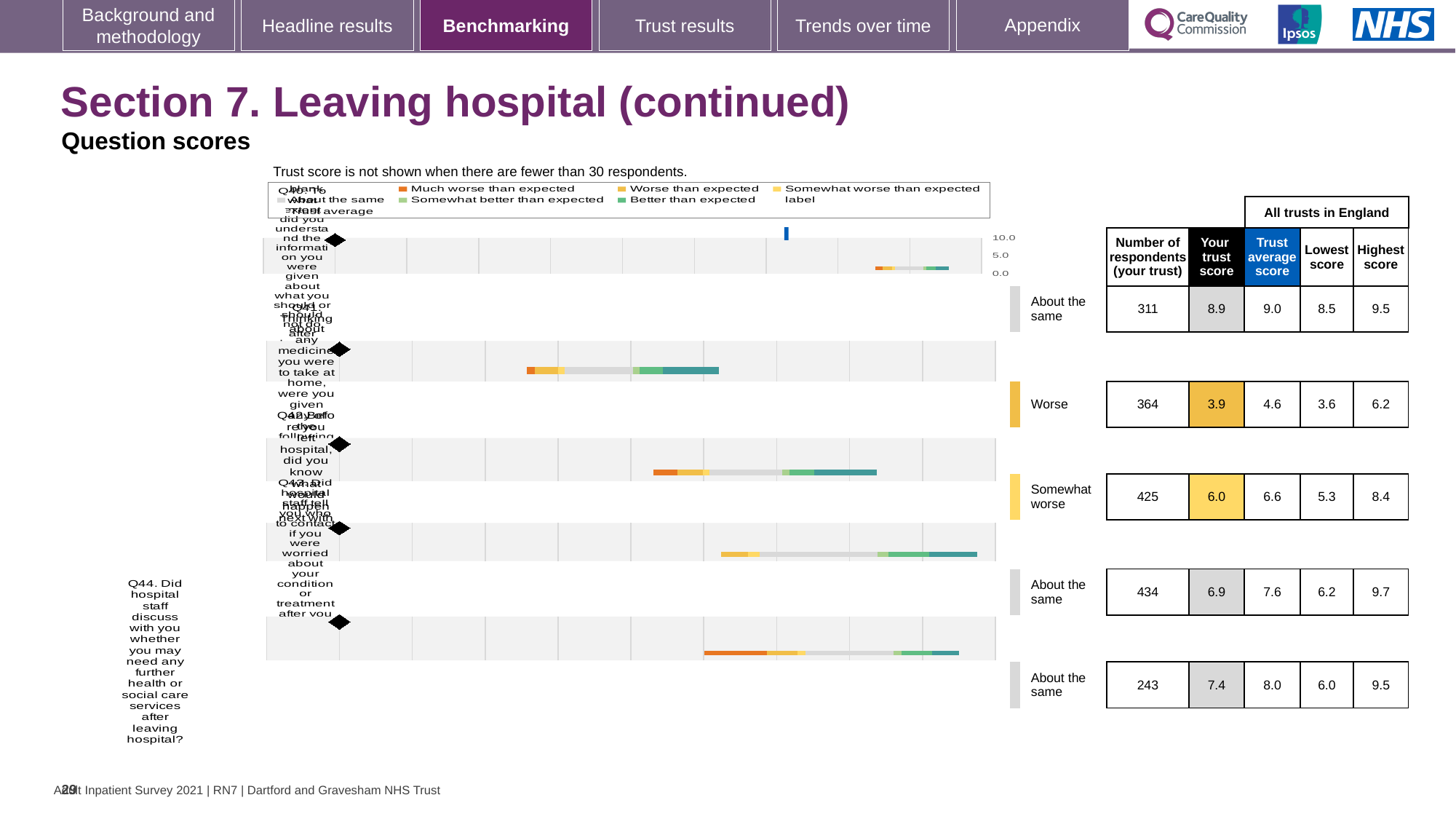
For Q44, how much higher is the trust average score than your trust score? 0.6 What is the 'Your trust score' for Q44 (Did hospital staff discuss with you whether you may need any further health or social care services after leaving hospital?)? 7.4 What is the 'Your trust score' for the question rated 'Worse' in the benchmarking table? 3.9 What benchmark category is Q44 given on this slide? About the same What kind of chart is used to show the question scores on this slide? Bar chart What is the highest 'Your trust score' shown in the table on this slide? 8.9 How many respondents from your trust answered Q44? 243 How many questions are shown in the benchmarking chart on this slide? 5 What is the lowest 'Your trust score' shown in the table on this slide? 3.9 What is the highest score across all trusts in England for the question rated 'Worse'? 6.2 What is the trust average score for the question rated 'Somewhat worse'? 6.6 For Q44, which is larger: your trust score or the trust average score? Trust average score